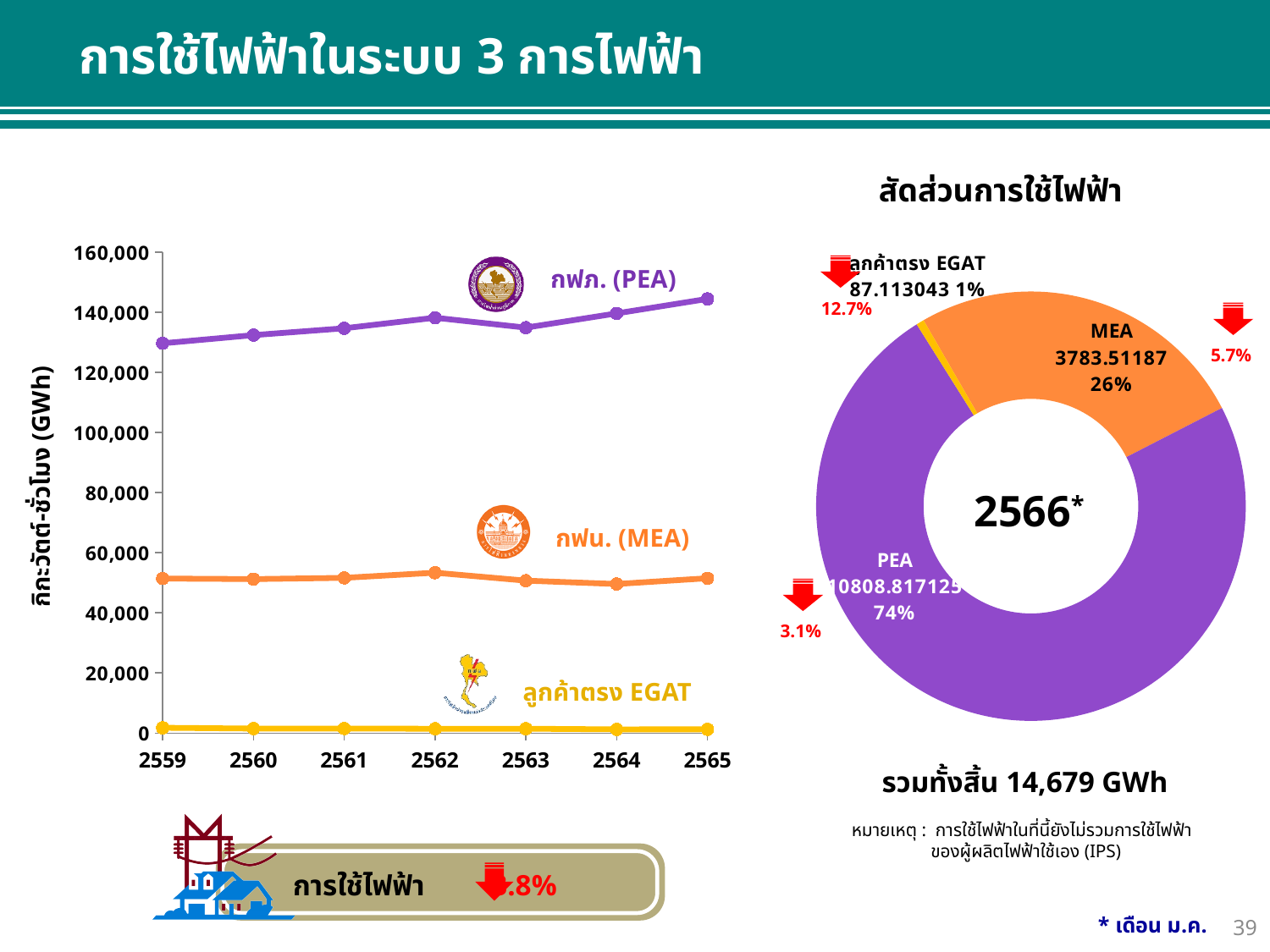
In the doughnut chart titled สัดส่วนการใช้ไฟฟ้า, what value is shown for MEA? 3783.51187 What kind of chart is the chart on the left side of the slide? line chart In the doughnut chart titled สัดส่วนการใช้ไฟฟ้า, which slice is the smallest? ลูกค้าตรง EGAT In the line chart on the left, is the value for กฟน. (MEA) in 2562 greater or less than 60,000? less In the line chart on the left, is the value for กฟภ. (PEA) in 2559 greater or less than 120,000? greater In the line chart on the left, how many years are shown on the x axis? 7 What total is printed below the doughnut chart titled สัดส่วนการใช้ไฟฟ้า? 14,679 GWh In the line chart on the left, how many series are plotted? 3 In the line chart on the left, does the กฟภ. (PEA) line generally rise or fall from 2559 to 2565? rise In the line chart on the left, which series has the highest values? กฟภ. (PEA) In the line chart on the left, which series has the lowest values? ลูกค้าตรง EGAT In the doughnut chart titled สัดส่วนการใช้ไฟฟ้า, what share does PEA have? 74%